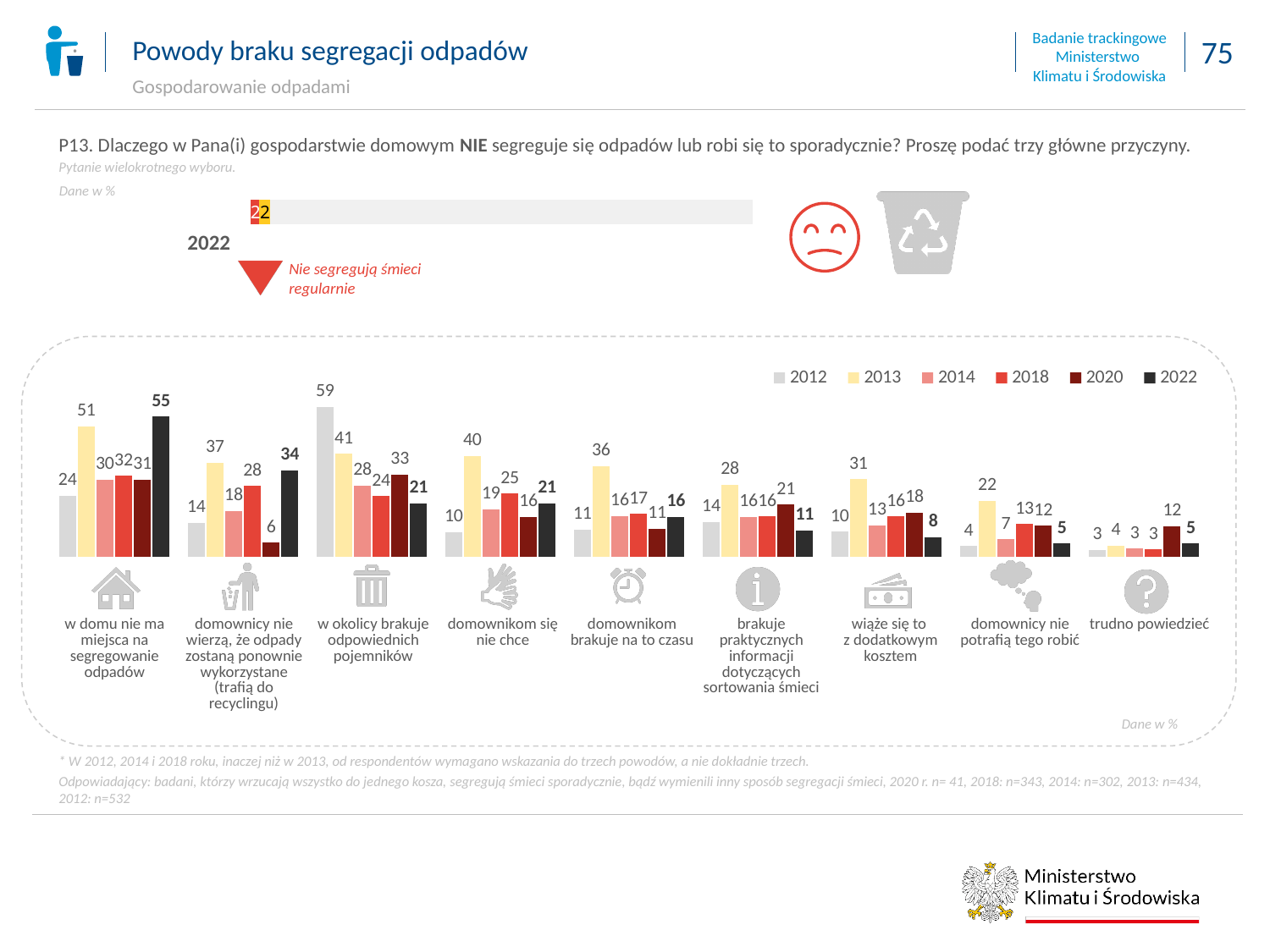
In the lower bar chart, which is larger for 'wiąże się to z dodatkowym kosztem': the 2020 value or the 2022 value? 2020 In the small chart at the top of the slide, what value is shown for 2022? 22 In the lower bar chart, which category has the lowest 2013 value? trudno powiedzieć In the lower bar chart, what is the 2020 value for 'domownicy nie wierzą, że odpady zostaną ponownie wykorzystane (trafią do recyclingu)'? 6 How many categories are shown in the lower bar chart? 9 How many series does the legend of the lower bar chart list? 6 What kind of chart is the lower chart on the slide? bar chart In the lower bar chart, which category has the highest 2022 value? w domu nie ma miejsca na segregowanie odpadów In the lower bar chart, what is the 2012 value for 'w okolicy brakuje odpowiednich pojemników'? 59 In the lower bar chart, what is the difference between the 2013 and 2022 values for 'domownikom się nie chce'? 19 In the lower bar chart, what is the 2022 value for 'w domu nie ma miejsca na segregowanie odpadów'? 55 In the lower bar chart, what is the 2020 value for 'trudno powiedzieć'? 12